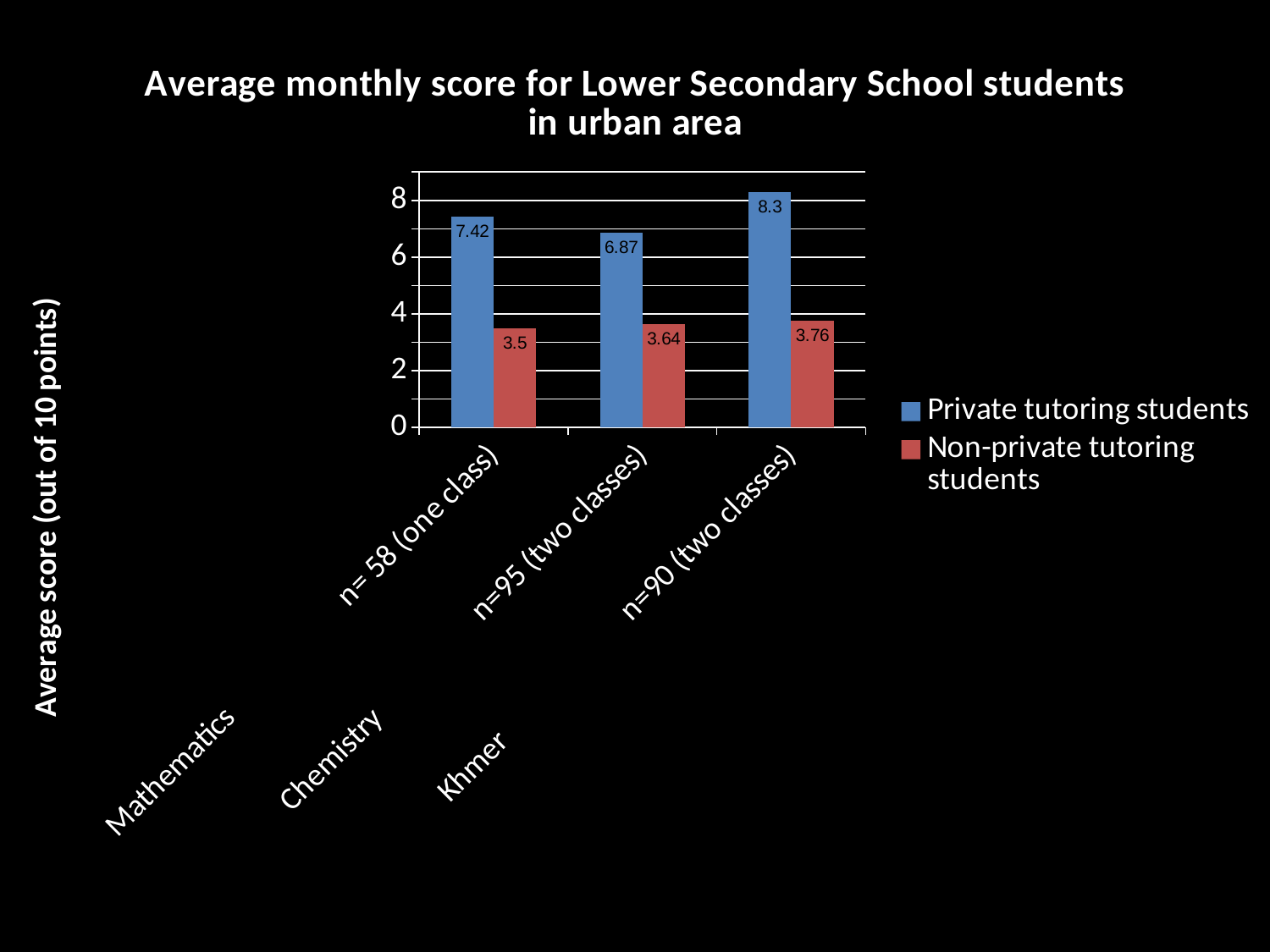
What is the average score for Private tutoring students in the n= 58 (one class) category? 7.42 Which is larger: the Private tutoring score for n= 58 (one class) or for n=95 (two classes)? n= 58 (one class) What is the average score for Non-private tutoring students in the n=90 (two classes) category? 3.76 Which category has the lowest score for Non-private tutoring students? n= 58 (one class) How many categories are shown on the x axis of the chart? 3 What colour represents Non-private tutoring students in the chart? Red How many series does the legend list? 2 What is the difference between the Private tutoring and Non-private tutoring scores in the n=95 (two classes) category? 3.23 What is the average score for Non-private tutoring students in the n=95 (two classes) category? 3.64 What is the difference between the Private tutoring and Non-private tutoring scores in the n=90 (two classes) category? 4.54 Which category has the highest score for Private tutoring students? n=90 (two classes) What kind of chart is shown on the slide? Bar chart